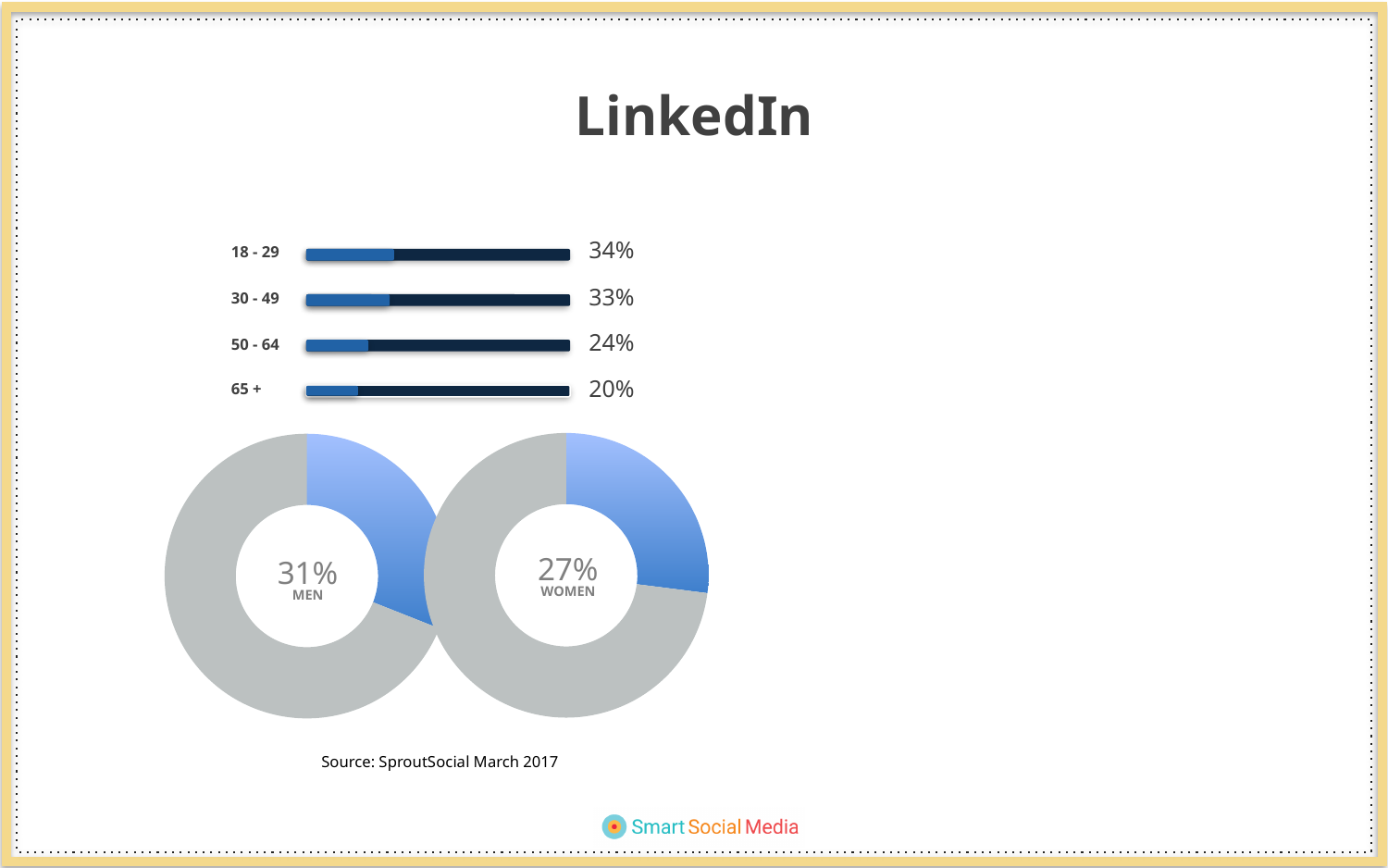
In the donut charts, which is larger: the value for men or the value for women? Men In the age-group bar chart, what is the value for the 65 + group? 20% In the age-group bar chart, which age group has the highest value? 18 - 29 In the age-group bar chart, what is the value for the 30 - 49 group? 33% How many age groups are shown in the bar chart? 4 In the age-group bar chart, what is the difference between the values for 18 - 29 and 65 +? 14% In the donut charts, what is the value shown for men? 31% In the age-group bar chart, what is the value for the 18 - 29 group? 34% In the age-group bar chart, what is the value for the 50 - 64 group? 24% In the age-group bar chart, which age group has the lowest value? 65 + In the age-group bar chart, which is larger: the value for 30 - 49 or the value for 50 - 64? 30 - 49 What kind of chart is used to show the age groups? Bar chart